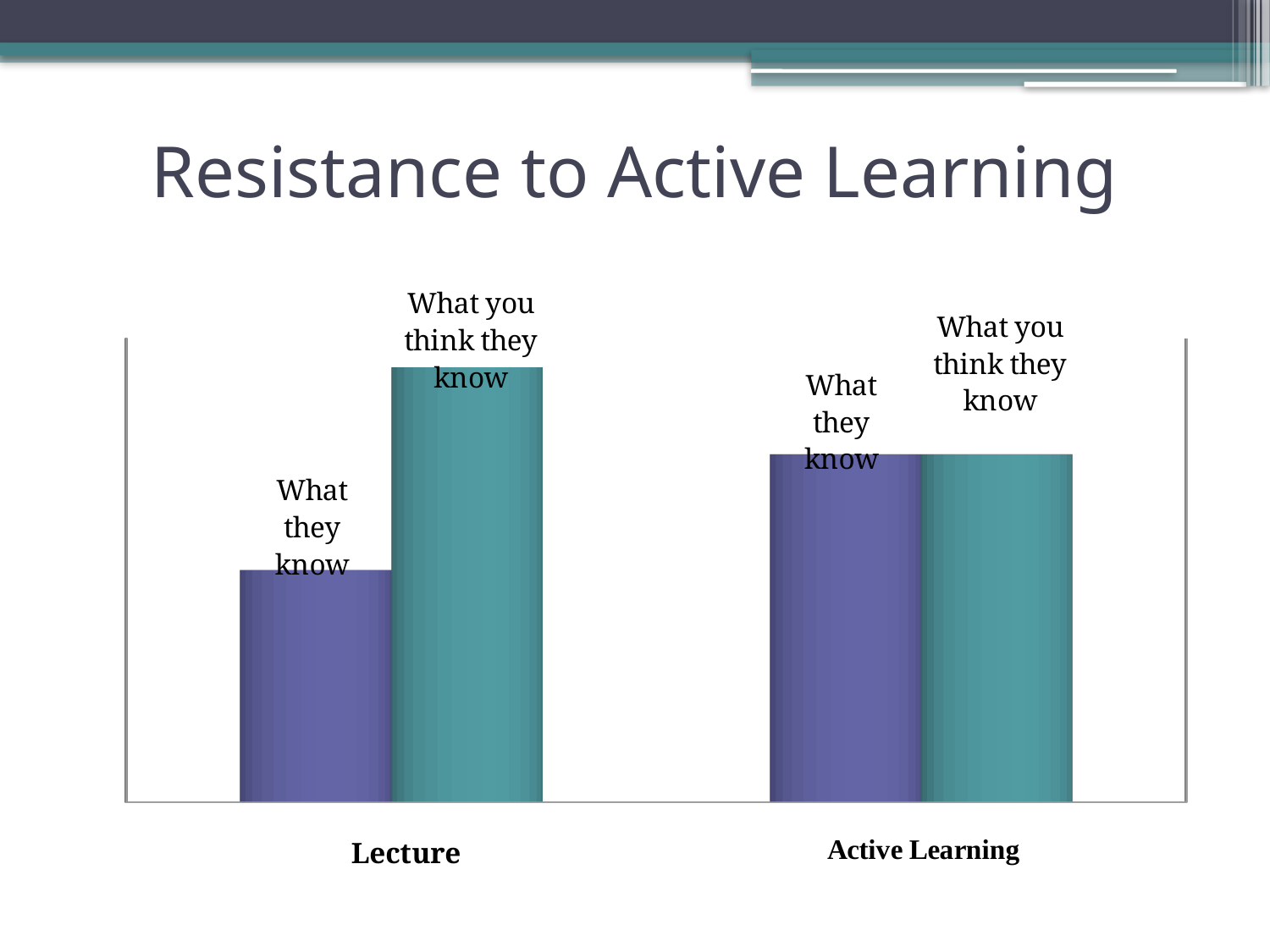
How many categories are shown along the x axis of the chart? 2 Which bar on the chart is the tallest? What you think they know (Lecture) For the Lecture category, which bar is taller: 'What they know' or 'What you think they know'? What you think they know Which bar on the chart is the shortest? What they know (Lecture) What kind of chart is shown on the slide? bar chart What is the title of the slide containing the chart? Resistance to Active Learning What are the two series plotted for each category? What they know and What you think they know How many bars are plotted for each category? 2 Is the 'What they know' bar for Active Learning taller or shorter than the 'What they know' bar for Lecture? taller What are the two categories shown along the x axis? Lecture and Active Learning Is the 'What you think they know' bar for Lecture taller or shorter than the 'What you think they know' bar for Active Learning? taller